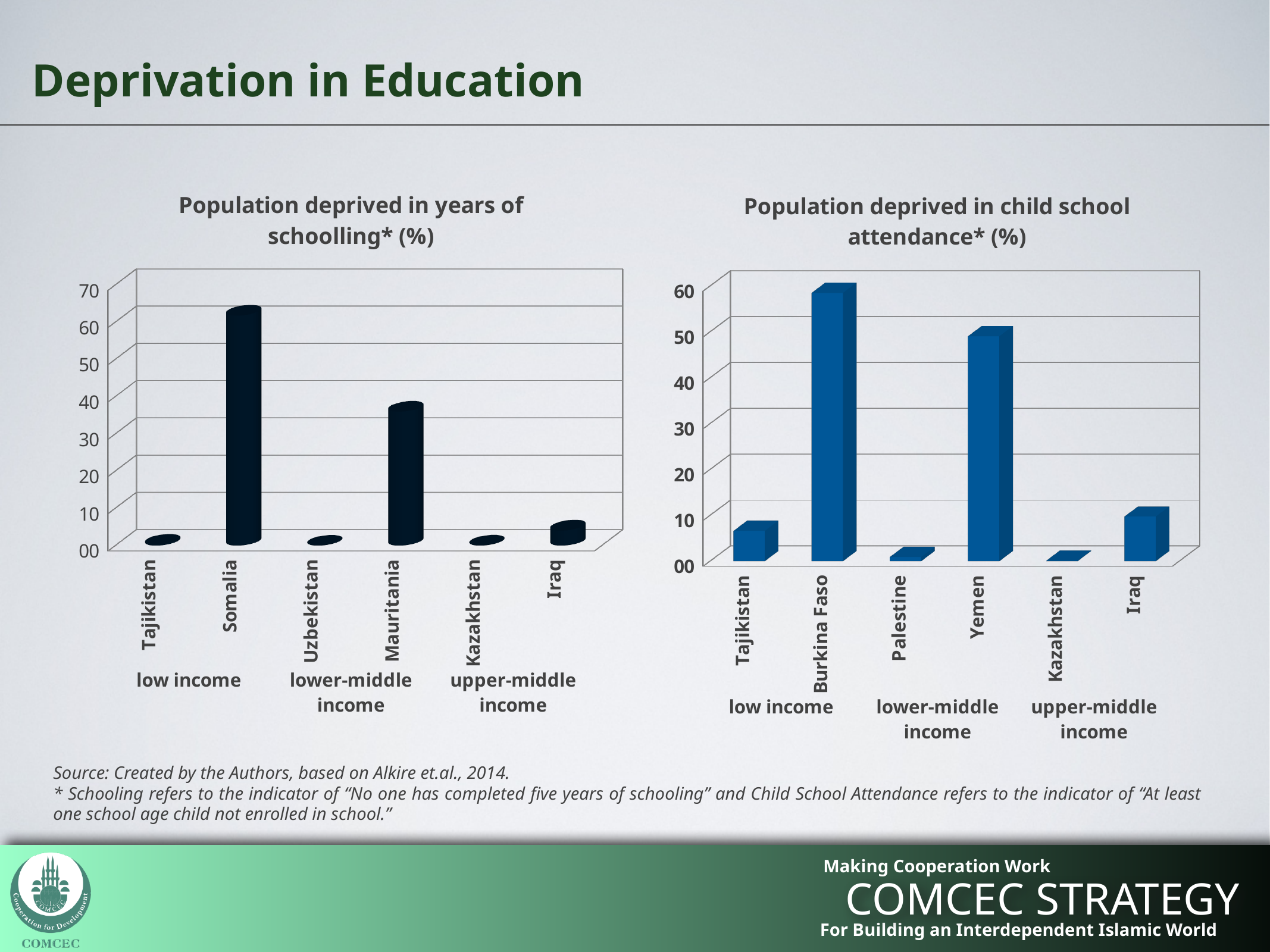
In the right chart, is the value for Yemen greater or less than 40? greater In the left chart, which is larger, the value for Mauritania or the value for Iraq? Mauritania How many countries are shown in the chart titled "Population deprived in child school attendance* (%)"? 6 In the left chart, is the value for Mauritania greater or less than 30? greater In the chart titled "Population deprived in years of schoolling* (%)", which country has the highest value? Somalia In the right chart, which is larger, the value for Burkina Faso or the value for Yemen? Burkina Faso What kind of chart is the chart titled "Population deprived in years of schoolling* (%)"? bar chart Which three income groups are labelled along the x axis of the right chart? low income, lower-middle income, upper-middle income In the right chart, is the value for Tajikistan greater or less than 10? less In the chart titled "Population deprived in child school attendance* (%)", which country has the highest value? Burkina Faso